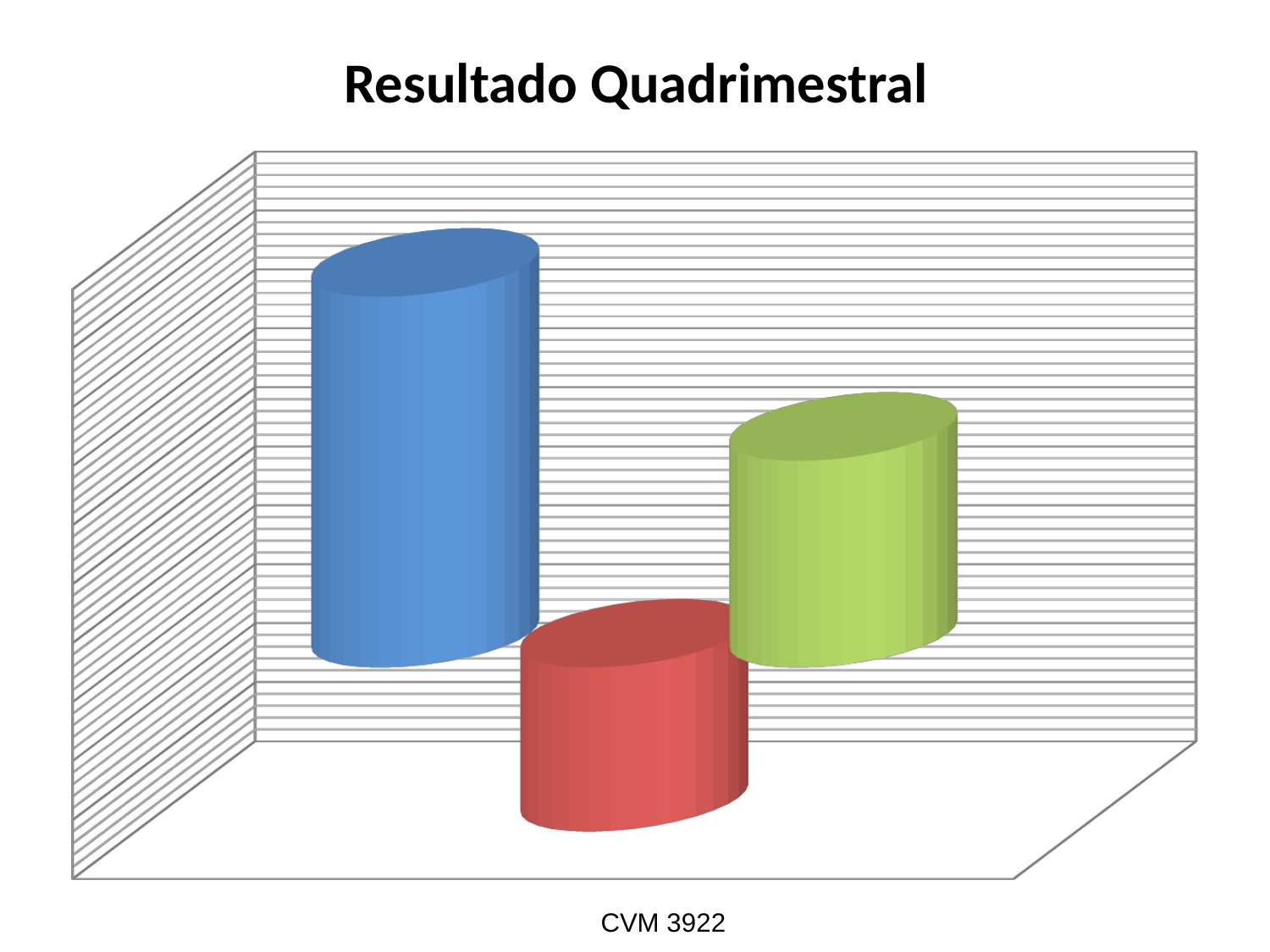
Which is taller, the blue bar or the green bar? the blue bar How many bars are plotted in the chart? 3 Which bar is the tallest in the chart: the blue, the red or the green one? the blue bar What colours are the three bars in the chart, from left to right? blue, red, green What is the title of the chart? Resultado Quadrimestral Which bar is the shortest in the chart: the blue, the red or the green one? the red bar What kind of chart is shown on the slide? bar chart Which is taller, the red bar or the green bar? the green bar